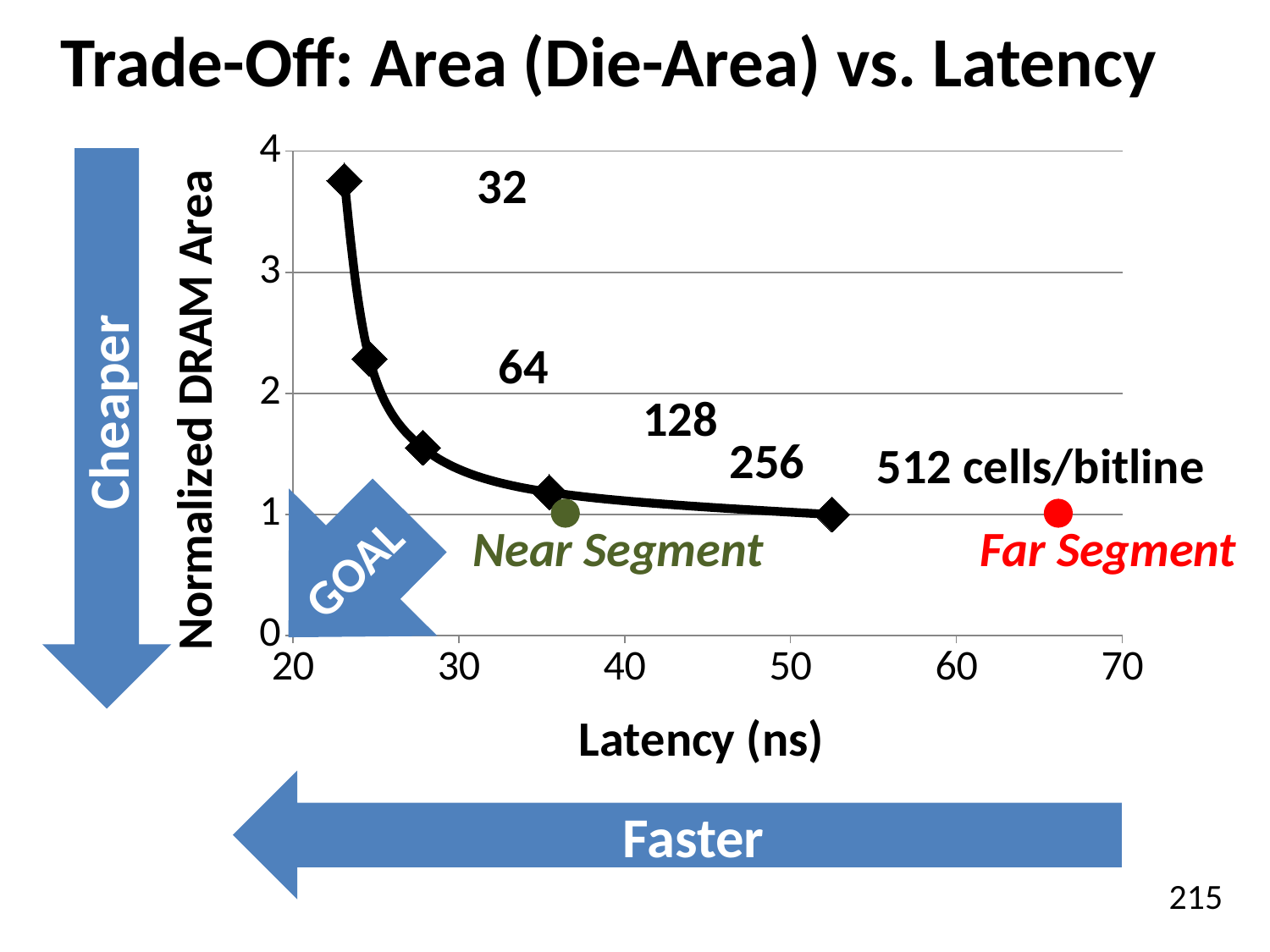
As latency increases along the x axis, does the normalized DRAM area rise or fall? fall Which cells/bitline configuration has the highest normalized DRAM area? 32 Is the normalized DRAM area for 128 cells/bitline greater or less than 2? less Which has the higher latency, the Near Segment point or the Far Segment point? Far Segment Is the normalized DRAM area for 32 cells/bitline greater or less than 3? greater What kind of chart is shown on the slide? line chart Is the normalized DRAM area for 64 cells/bitline greater or less than 2? greater Which cells/bitline configuration has the lowest normalized DRAM area? 512 What is the title of the y axis? Normalized DRAM Area What is the title of the x axis? Latency (ns) How many diamond-marked data points are on the black curve? 5